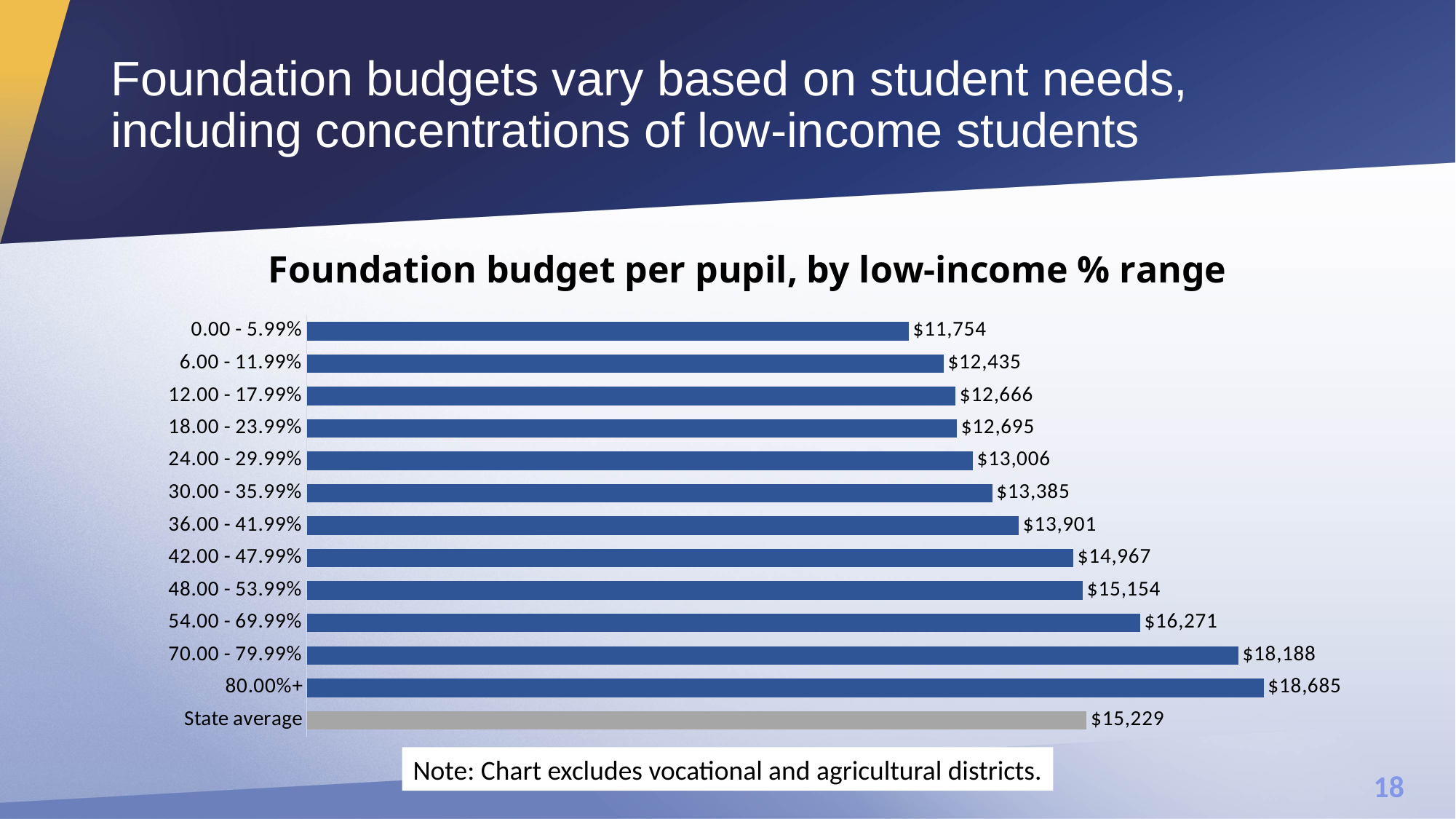
What is the foundation budget per pupil for the 0.00 - 5.99% low-income range? $11,754 Do the foundation budget values rise or fall as the low-income % range increases from 0.00 - 5.99% to 80.00%+? Rise What is the difference between the foundation budget per pupil for the 80.00%+ range and the 0.00 - 5.99% range? $6,931 How many bars are plotted on the chart, including the State average? 13 What is the State average foundation budget per pupil shown on the chart? $15,229 What is the foundation budget per pupil for the 42.00 - 47.99% range? $14,967 What kind of chart is shown on the slide? Bar chart Which low-income % range has the lowest foundation budget per pupil? 0.00 - 5.99% What is the foundation budget per pupil for the 80.00%+ low-income range? $18,685 What is the title of the chart? Foundation budget per pupil, by low-income % range Which low-income % range has the highest foundation budget per pupil? 80.00%+ Which is larger: the foundation budget per pupil for the 54.00 - 69.99% range or the State average? 54.00 - 69.99%